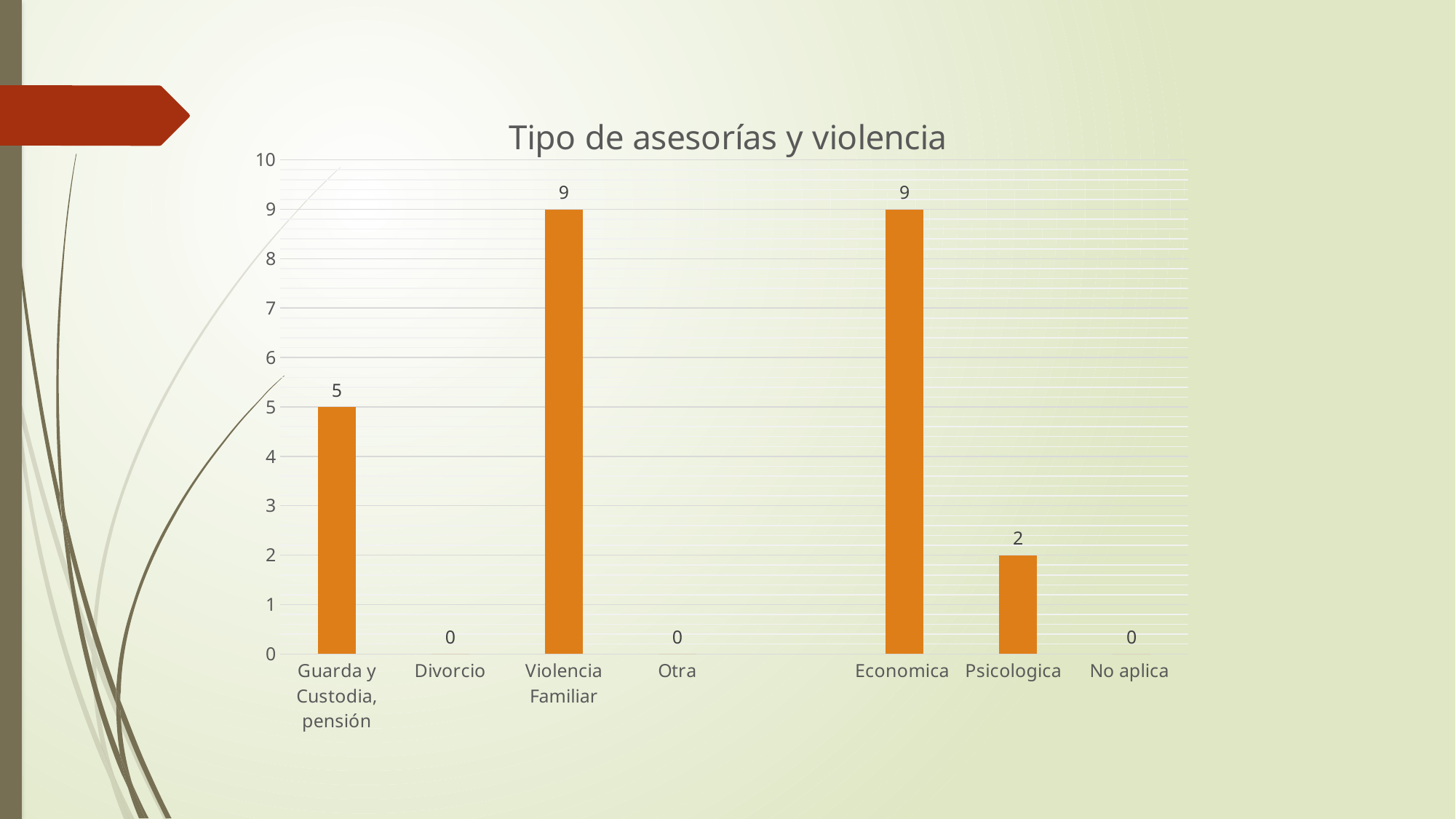
What is the value for Guarda y Custodia, pensión? 5 Which has a larger value, Guarda y Custodia, pensión or Psicologica? Guarda y Custodia, pensión What is the value for Psicologica? 2 What is the value for Economica? 9 What is the value for Violencia Familiar? 9 What is the value for Divorcio? 0 Is the value for Economica greater or less than 5? greater What is the difference between the values for Violencia Familiar and Psicologica? 7 Which two categories share the highest value in the chart? Violencia Familiar and Economica What is the difference between the values for Guarda y Custodia, pensión and Psicologica? 3 What is the title of the chart? Tipo de asesorías y violencia What kind of chart is shown on the slide? bar chart